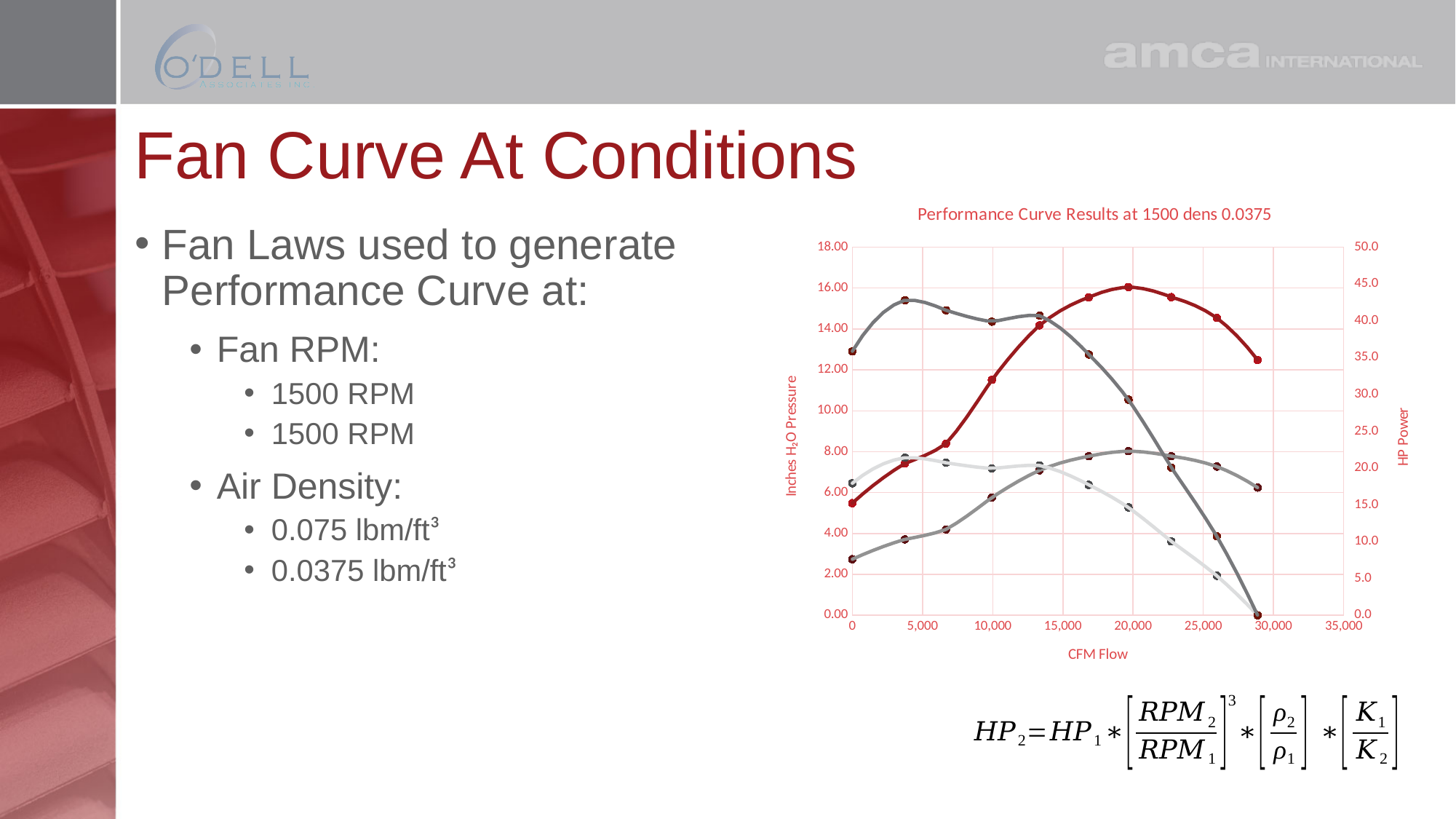
What is the title of the chart? Performance Curve Results at 1500 dens 0.0375 Does the dark red line rise or fall between 0 and 20,000 CFM Flow? rise Does the dark red line rise or fall between 20,000 and 30,000 CFM Flow? fall Does the light grey line rise or fall between 15,000 and 30,000 CFM Flow? fall What is the label of the x axis of the chart? CFM Flow What type of chart is shown on the slide? line chart